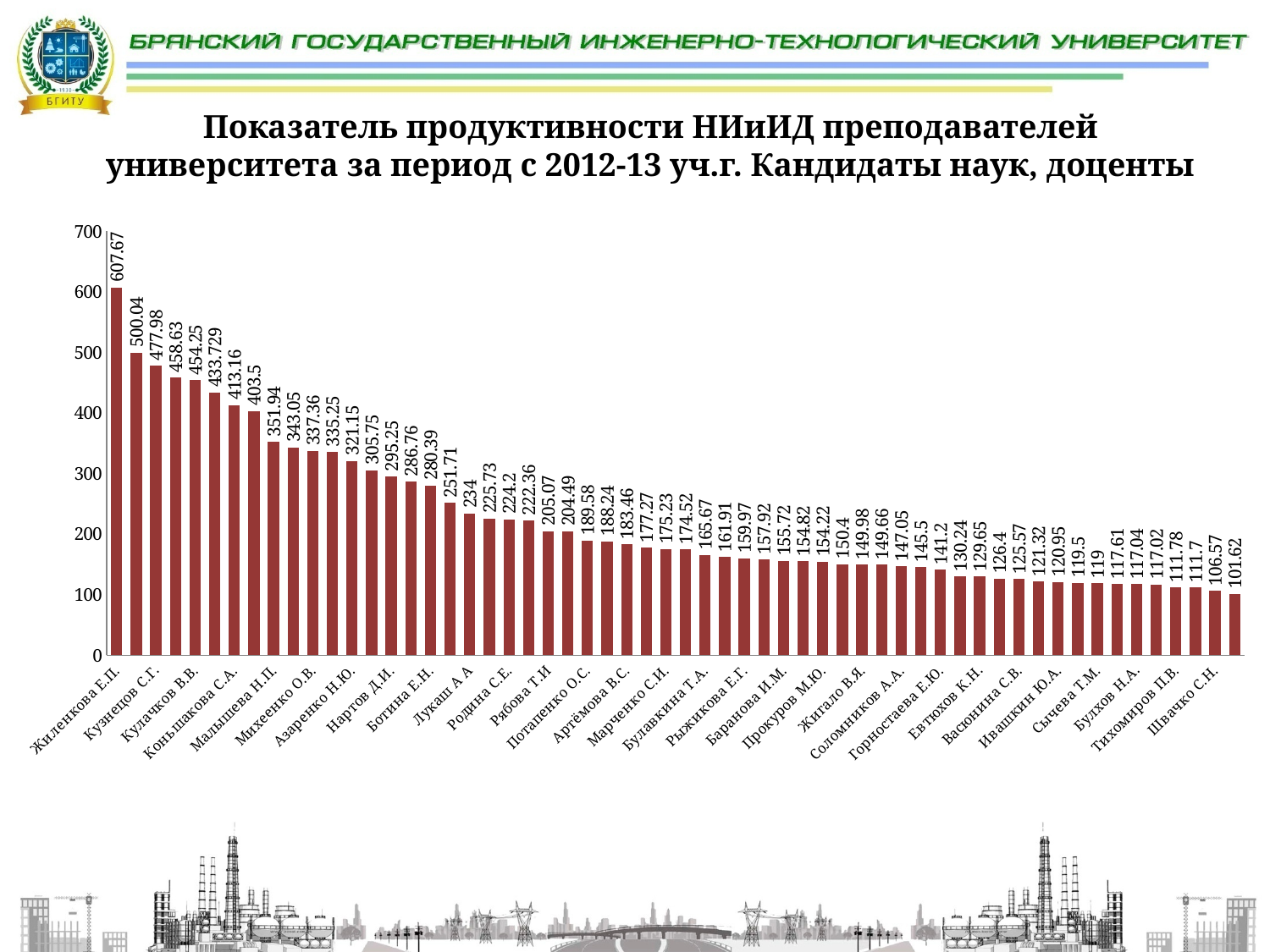
What is the highest value shown on the chart? 607.67 Do the values rise or fall from left to right along the x axis? fall What kind of chart is shown on the slide? bar chart What is the lowest value shown on the chart? 101.62 What is the maximum value shown on the vertical axis? 700 Which is larger, the value for Жиленкова Е.П. or the value of the second bar? Жиленкова Е.П. What is the value for Жиленкова Е.П.? 607.67 How many bars are plotted on the chart? 58 Which category has the highest value? Жиленкова Е.П. Is the value for Жиленкова Е.П. greater or less than 600? greater What is the difference between the first bar (607.67) and the second bar (500.04)? 107.63 What is the difference between the highest value (607.67) and the lowest value (101.62)? 506.05